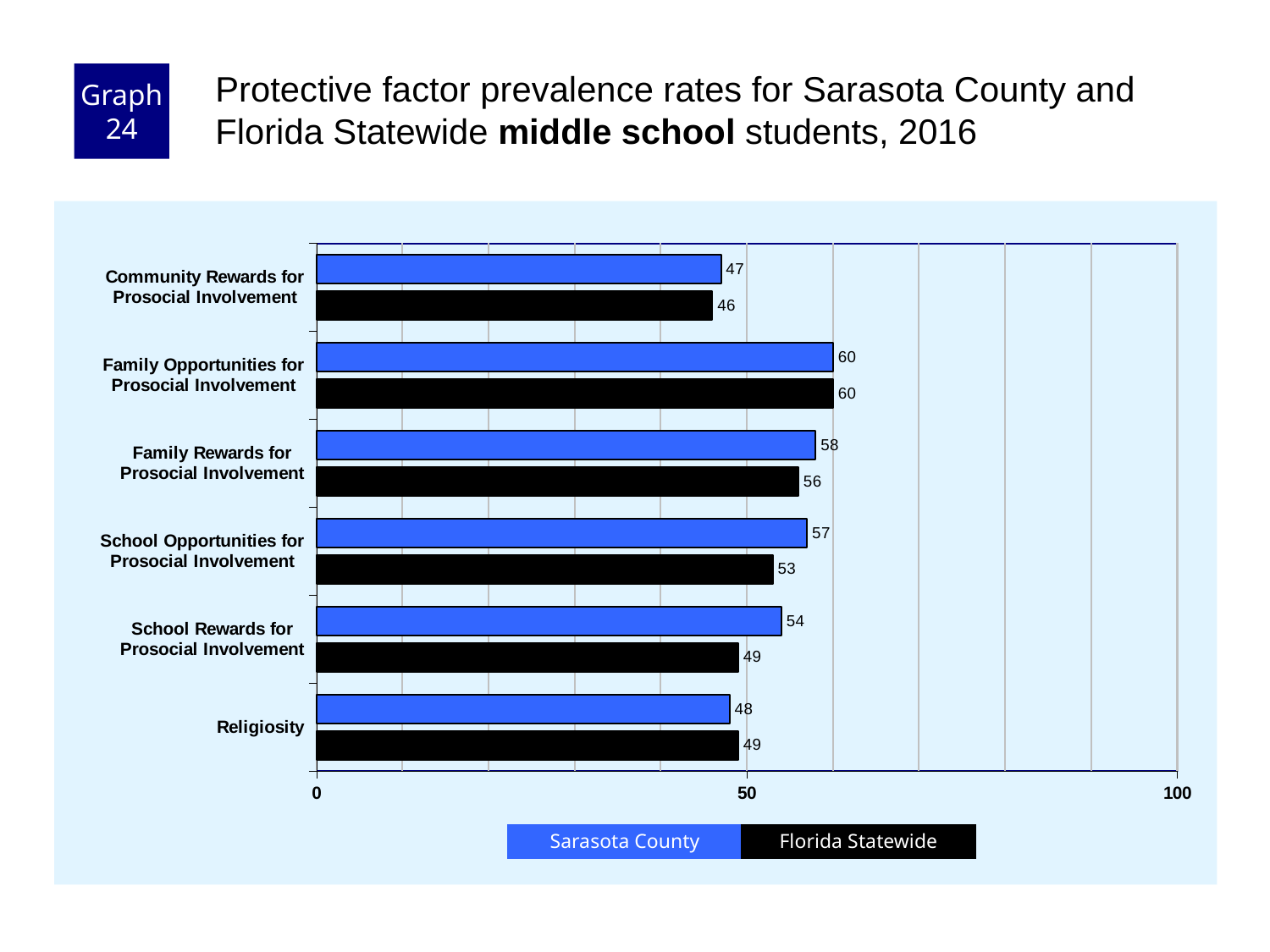
How many protective factor categories are shown on the chart? 6 What is the Sarasota County value for Community Rewards for Prosocial Involvement? 47 What is the Florida Statewide value for School Opportunities for Prosocial Involvement? 53 Which category has the lowest Florida Statewide value? Community Rewards for Prosocial Involvement What is the difference between the Sarasota County and Florida Statewide values for School Rewards for Prosocial Involvement? 5 What kind of chart is shown on the slide? bar chart For Religiosity, which is larger: the Sarasota County value or the Florida Statewide value? Florida Statewide What is the Florida Statewide value for Religiosity? 49 Is the Sarasota County value for Family Rewards for Prosocial Involvement greater or less than 50? greater Which colour represents Florida Statewide in the chart? black How many series does the legend list? 2 Which category has the highest Sarasota County value? Family Opportunities for Prosocial Involvement